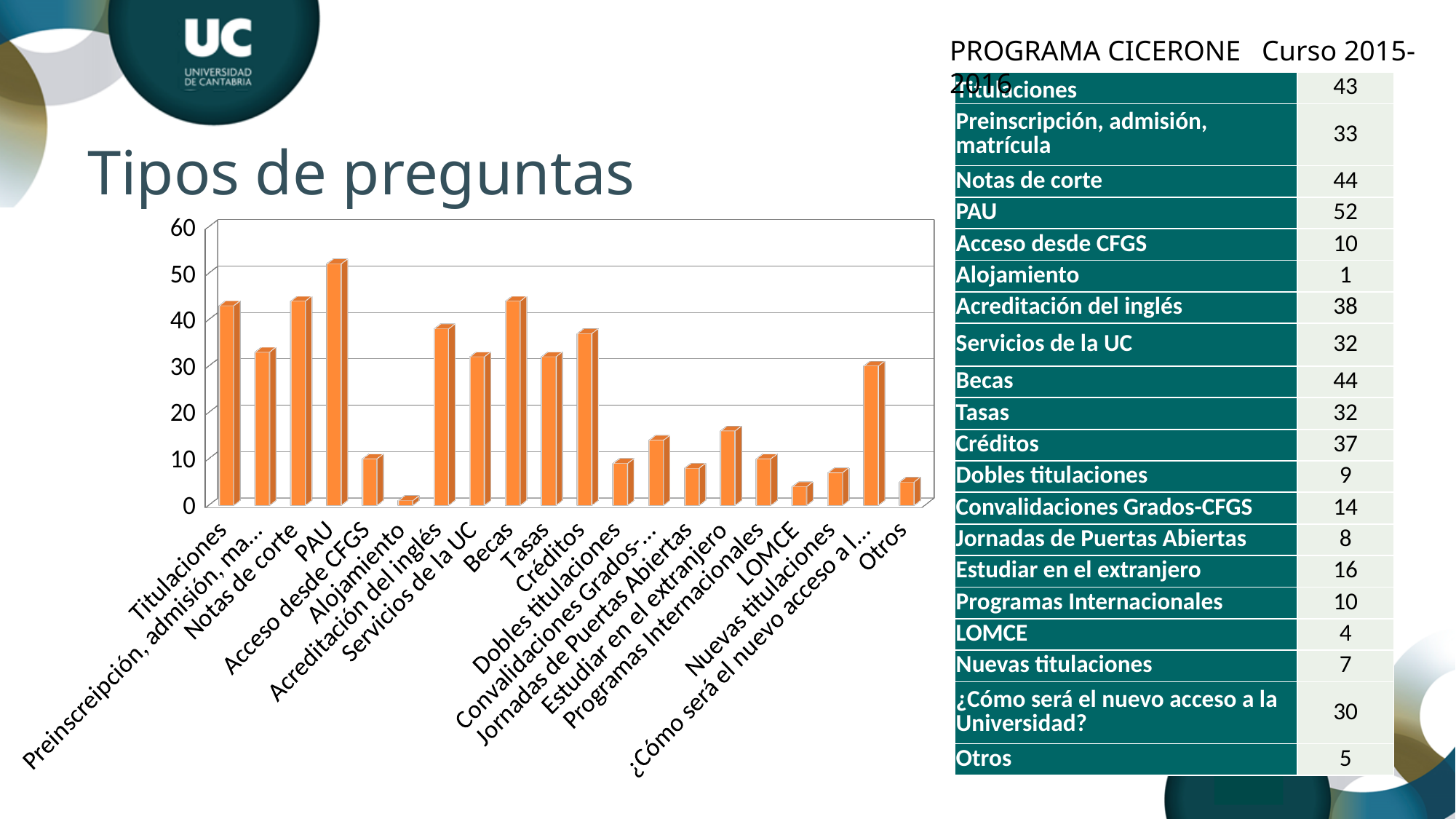
What kind of chart is shown on the slide? bar chart What is the difference between the values for PAU and Titulaciones? 9 Is the value for Estudiar en el extranjero greater or less than 10? greater What is the value for Acreditación del inglés? 38 What is the value for LOMCE? 4 Is the value for Otros greater or less than 10? less Which category has the lowest value in the chart? Alojamiento What is the value for PAU? 52 What is the chart's title? Tipos de preguntas Which category has the highest value in the chart? PAU Which is larger, the value for Becas or the value for Tasas? Becas How many categories are plotted in the chart? 20